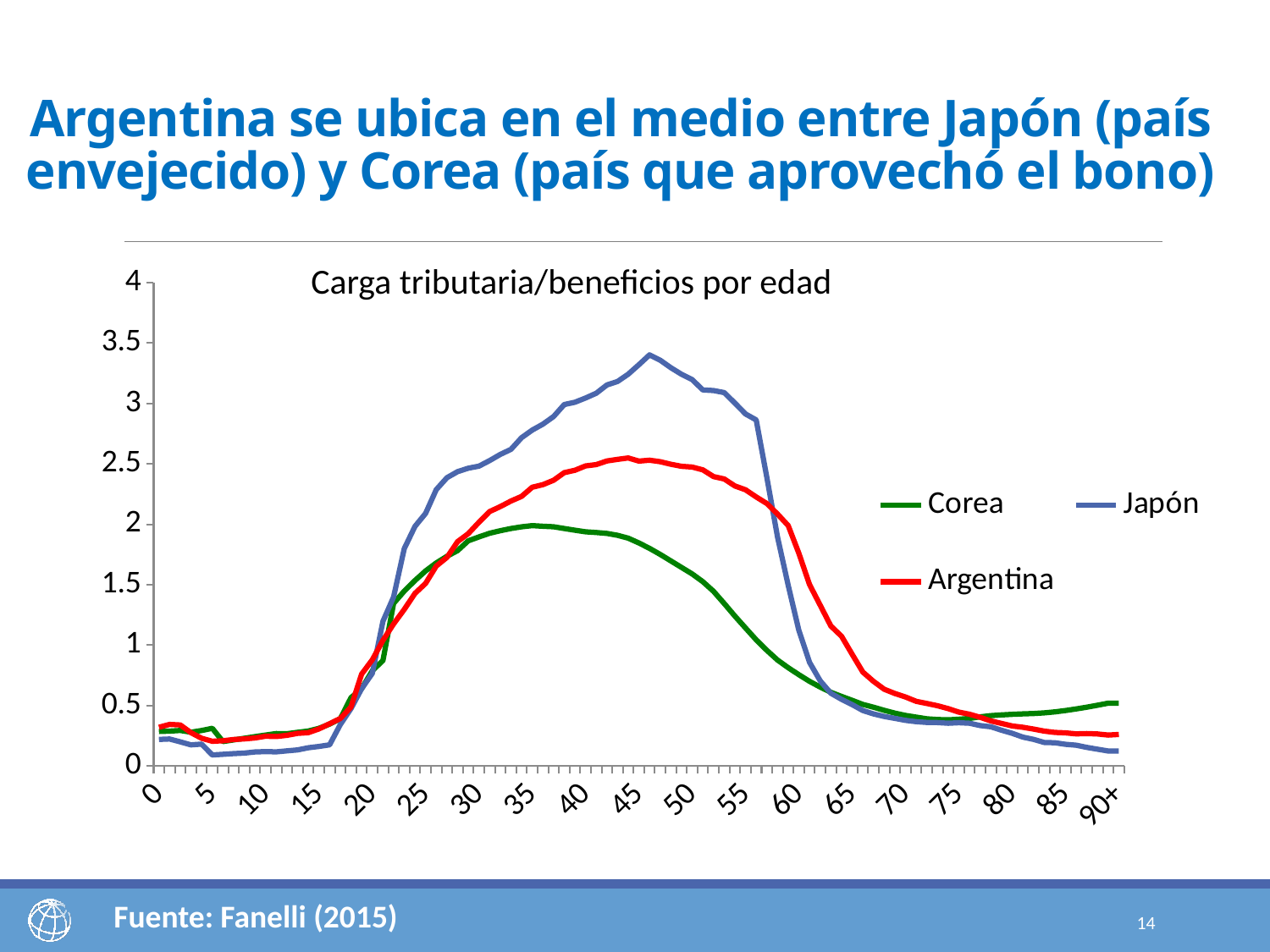
What kind of chart is shown on the slide? line chart Does the Japón line rise or fall between ages 55 and 65? fall Does the Corea line rise or fall between ages 20 and 35? rise What is the title of the chart? Carga tributaria/beneficios por edad How many series does the legend list? 3 What colour is the Argentina line? red At age 60, which series has the larger value, Argentina or Corea? Argentina Which series has the lowest value at age 45? Corea Is the value for Argentina at age 45 greater or less than 2? greater Is the value for Japón at age 65 greater or less than 1? less Which series reaches the highest peak value on the chart? Japón Is the value for Japón at age 45 greater or less than 3? greater